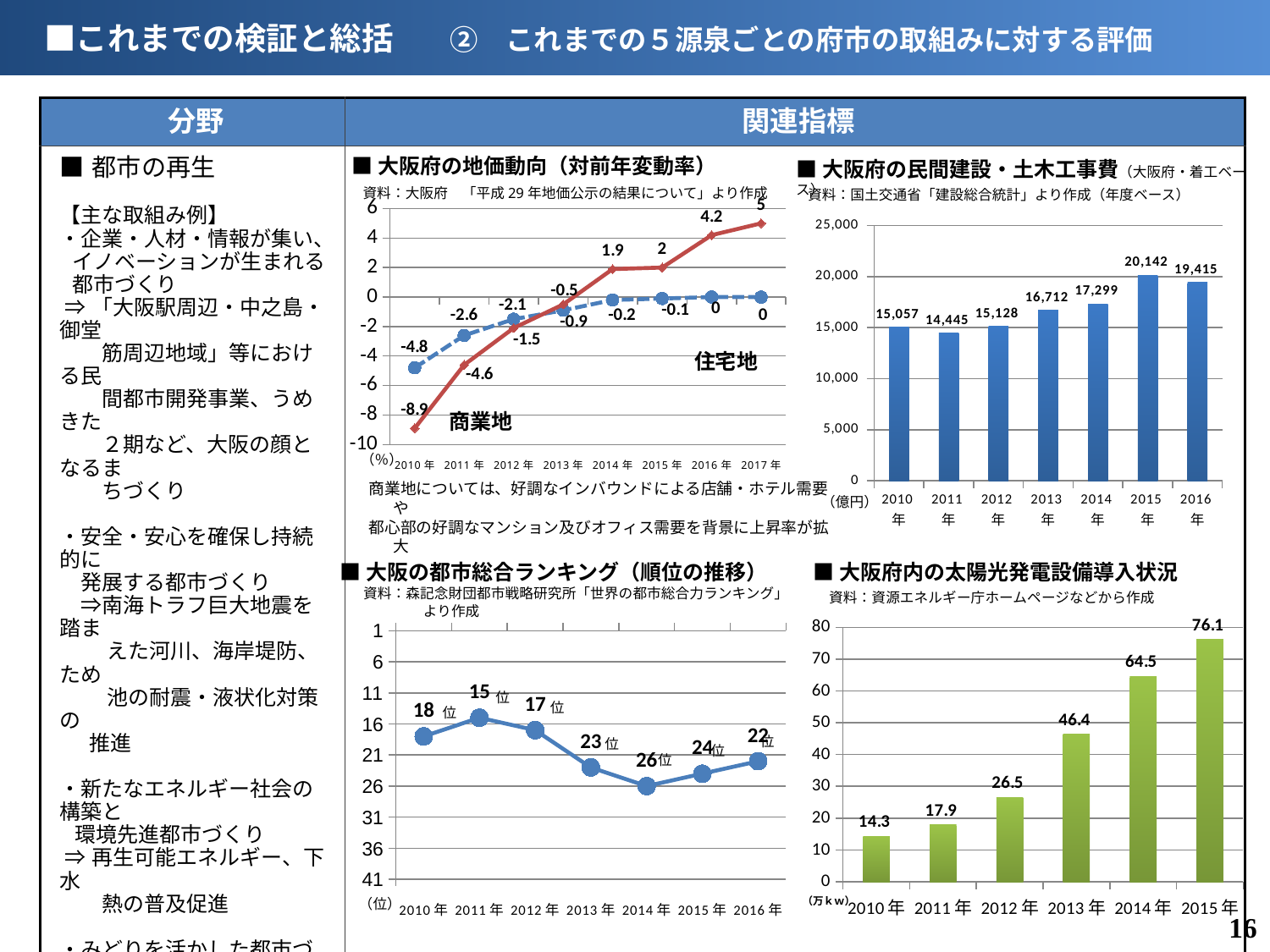
In the 大阪府の地価動向 chart, which is larger in 2017年, 商業地 or 住宅地? 商業地 In the 大阪府内の太陽光発電設備導入状況 chart, what is the value for 2013年? 46.4 In the 大阪の都市総合ランキング chart, what rank is shown for 2011年? 15位 In the 大阪府の民間建設・土木工事費 chart, what is the difference between the 2015年 and 2016年 values? 727 What kind of chart is the 大阪府内の太陽光発電設備導入状況 chart? bar chart In the 大阪府内の太陽光発電設備導入状況 chart, which year has the highest value? 2015年 In the 大阪の都市総合ランキング chart, what rank is shown for 2014年? 26位 In the 大阪府内の太陽光発電設備導入状況 chart, do the values rise or fall from 2010年 to 2015年? rise In the 大阪府の地価動向 chart, what is the 商業地 value for 2010年? -8.9 In the 大阪府の民間建設・土木工事費 chart, what is the value for 2015年? 20,142 In the 大阪府の民間建設・土木工事費 chart, which year has the lowest value? 2011年 In the 大阪府の民間建設・土木工事費 chart, how many years are plotted? 7